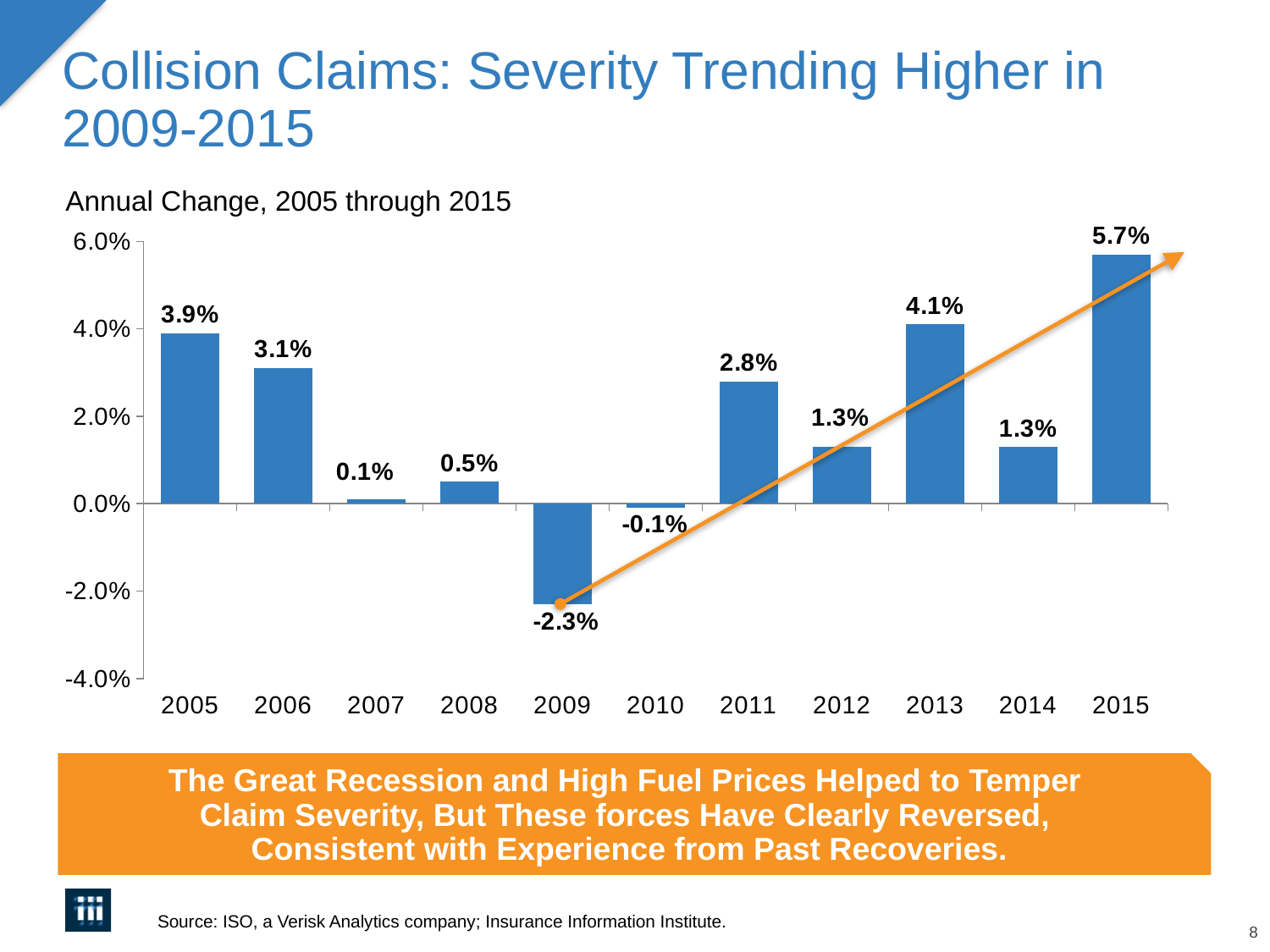
What is the subtitle printed above the chart? Annual Change, 2005 through 2015 What is the annual change shown for 2013? 4.1% Which year has the highest annual change? 2015 Do the values generally rise or fall from 2009 to 2015? Rise What is the annual change shown for 2007? 0.1% What kind of chart is shown on the slide? Bar chart What is the difference between the annual change in 2015 and the annual change in 2005? 1.8% Which year has the lowest annual change? 2009 What is the annual change in collision claim severity for 2009? -2.3% Which year has the larger annual change, 2011 or 2006? 2006 Is the value for 2013 greater or less than 2.0%? greater How many years are shown on the x axis? 11